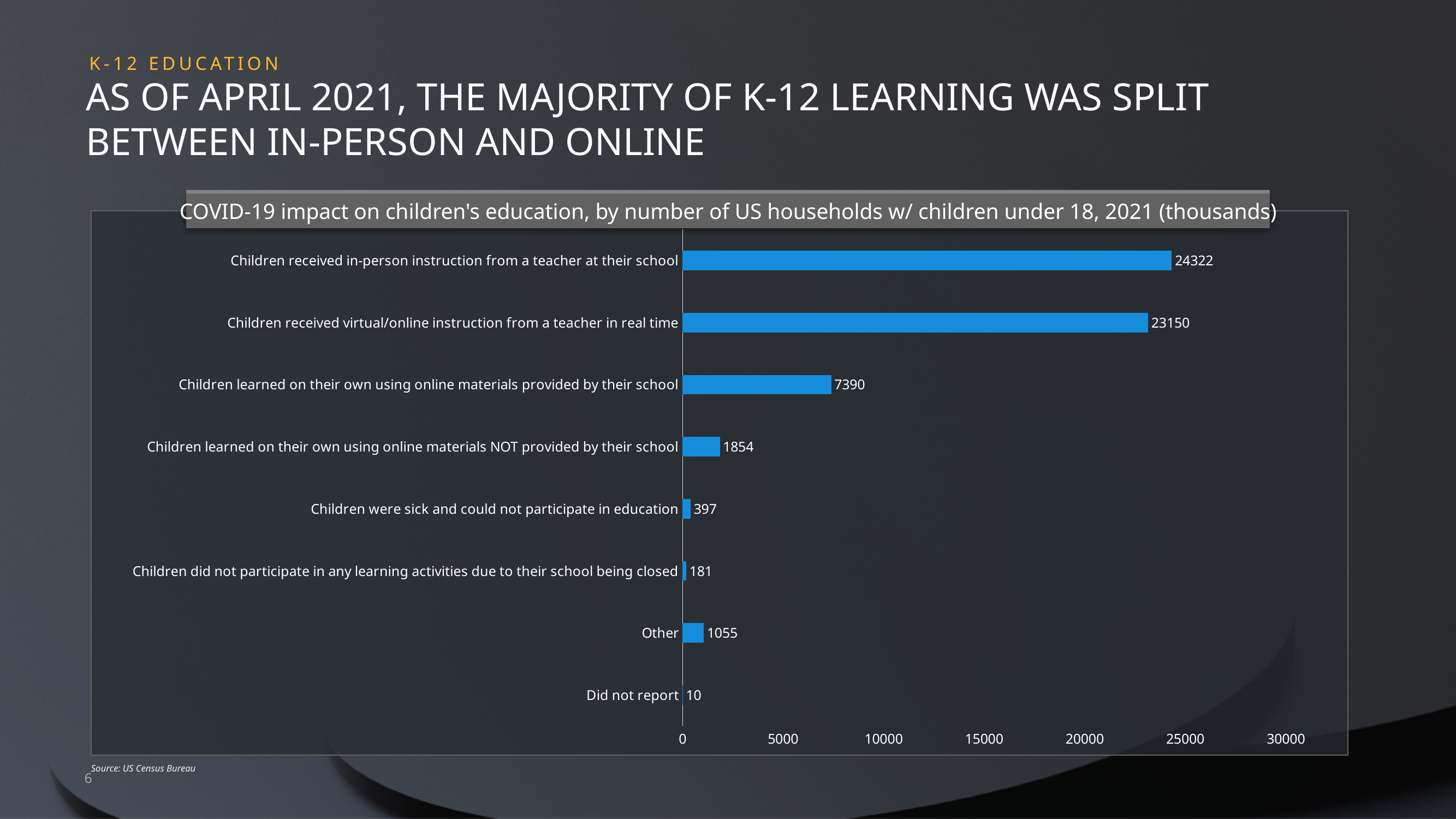
Which is larger: the value for 'Other' or the value for 'Children did not participate in any learning activities due to their school being closed'? Other What is the value for 'Children received virtual/online instruction from a teacher in real time'? 23150 What is the value for 'Children received in-person instruction from a teacher at their school'? 24322 How many categories are shown in the chart? 8 What is the value for 'Children learned on their own using online materials provided by their school'? 7390 What is the value for 'Children were sick and could not participate in education'? 397 What is the difference between the values for in-person instruction from a teacher at their school and virtual/online instruction from a teacher in real time? 1172 Which category has the lowest value? Did not report What kind of chart is shown on the slide? Bar chart Is the value for 'Children learned on their own using online materials provided by their school' greater or less than 10000? less Which category has the highest value? Children received in-person instruction from a teacher at their school What is the title of the chart? COVID-19 impact on children's education, by number of US households w/ children under 18, 2021 (thousands)